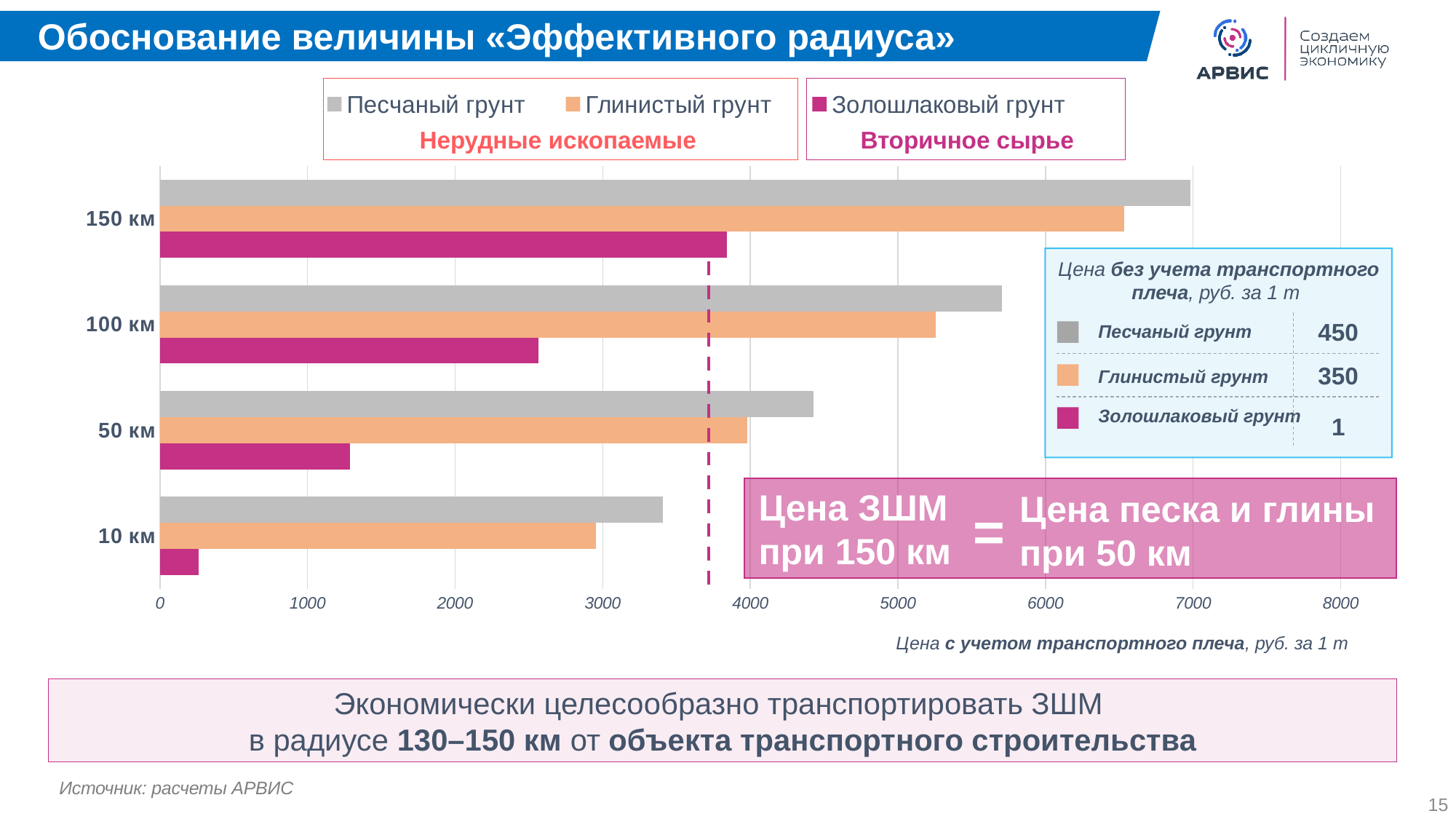
At 100 км, which is larger: the value for Глинистый грунт or the value for Золошлаковый грунт? Глинистый грунт What kind of chart is shown on the slide? Bar chart How many series does the chart legend list? 3 How many distance categories are shown on the chart's vertical axis? 4 Is the value for Песчаный грунт at 50 км greater or less than 4000? greater Which series has the longest bar in the 150 км category? Песчаный грунт Which colour represents Золошлаковый грунт in the chart? Magenta (pink) Do the values for Золошлаковый грунт rise or fall as the distance increases from 10 км to 150 км? rise Which series has the shortest bar in the 10 км category? Золошлаковый грунт Is the value for Золошлаковый грунт at 100 км greater or less than 3000? less Is the value for Песчаный грунт at 150 км greater or less than 6000? greater